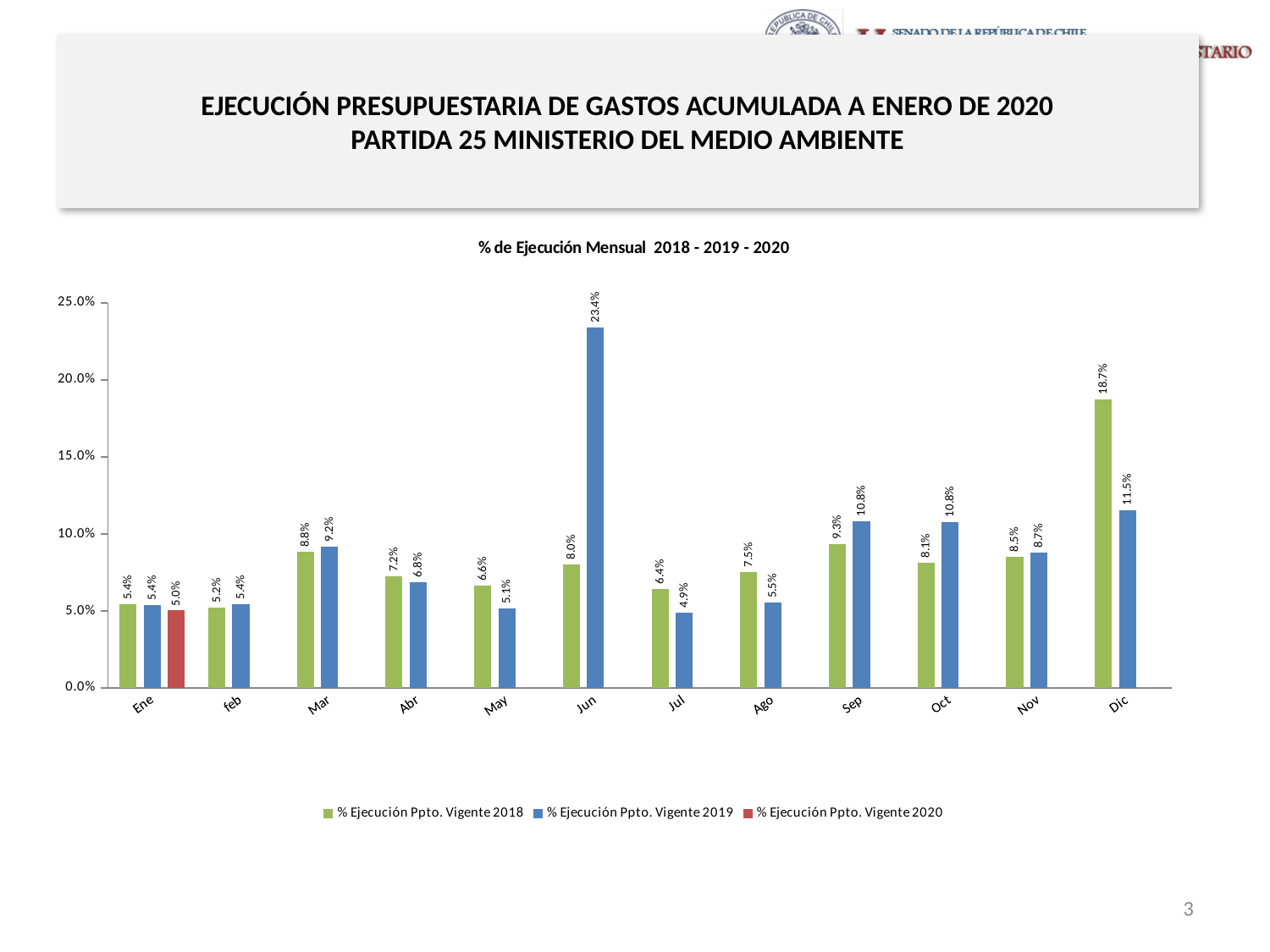
What is the value for Dic in the % Ejecución Ppto. Vigente 2018 series? 18.7% What is the difference between the 2018 and 2019 values for Dic? 7.2% What kind of chart is shown on the slide? Bar chart Which month has the lowest value in the % Ejecución Ppto. Vigente 2019 series? Jul Which is larger for Jul: the 2018 value or the 2019 value? 2018 What is the value for Jun in the % Ejecución Ppto. Vigente 2019 series? 23.4% How many series does the legend list? 3 What is the value for Ene in the % Ejecución Ppto. Vigente 2020 series? 5.0% How many months are shown on the x axis? 12 Which month has the highest value in the % Ejecución Ppto. Vigente 2019 series? Jun What is the title of the chart? % de Ejecución Mensual 2018 - 2019 - 2020 Is the value for Dic in the 2018 series greater or less than 15.0%? greater